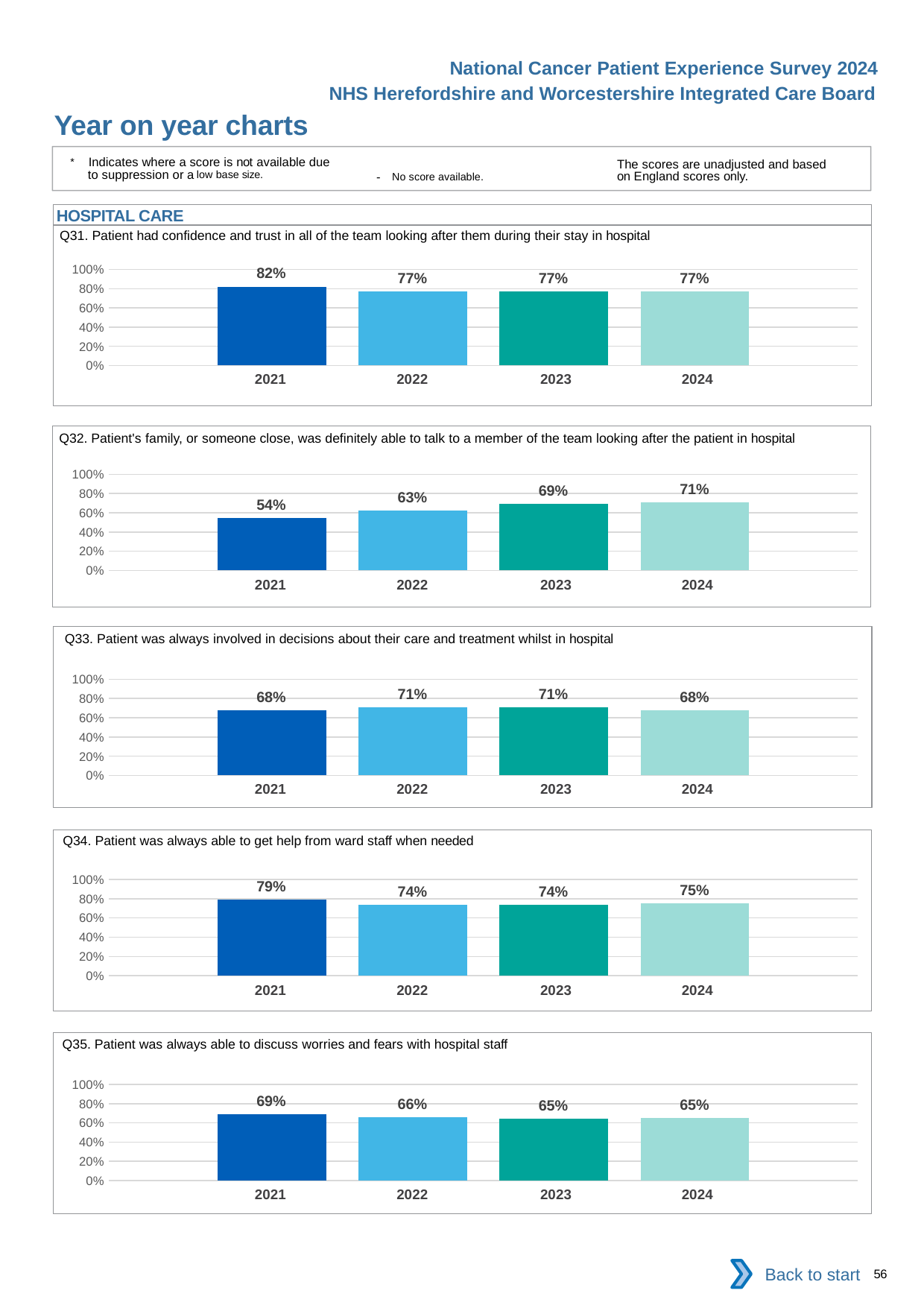
What kind of chart is used for Q33? bar chart How many years are shown in the Q31 chart? 4 In the Q32 chart, what is the difference between the 2024 and 2021 values? 17 percentage points In the Q32 chart, do the values rise or fall from 2021 to 2024? rise In the Q34 chart, which year has the lowest value? 2022 and 2023 (both 74%) In the Q35 chart, what is the difference between the 2021 and 2022 values? 3 percentage points In the Q34 chart, is the value for 2021 larger than the value for 2024? Yes, 2021 (79%) is larger In the Q32 chart, which year has the highest value? 2024 How many charts are shown on the slide under the Hospital Care section? 5 In the Q33 chart, what is the value for 2022? 71% In the Q31 chart, what is the value for 2021? 82% In the Q35 chart, what is the value for 2024? 65%